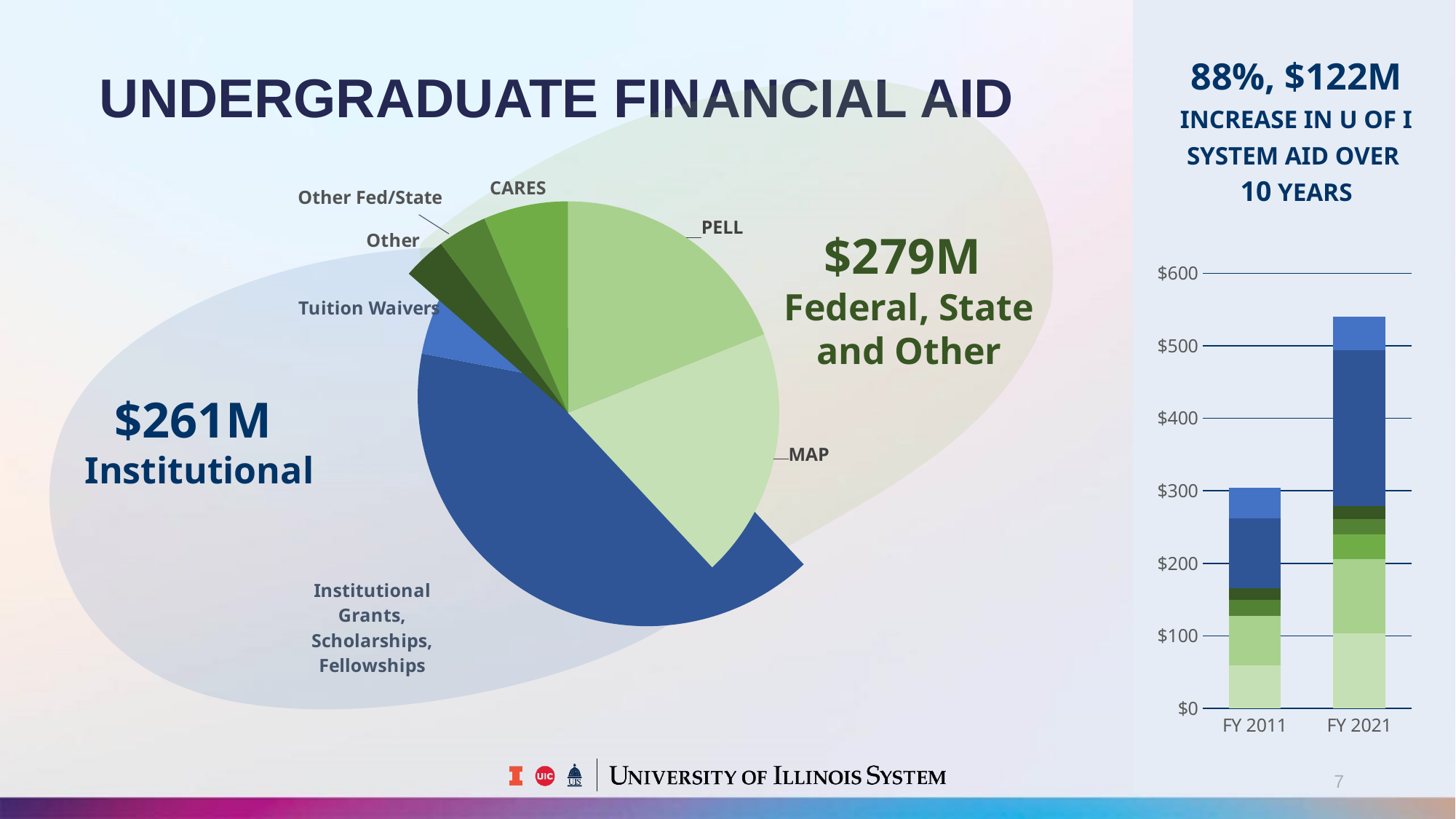
In the bar chart on the right, is the total for FY 2021 greater or less than $500? greater How many bars are in the bar chart on the right? 2 How many slices does the pie chart have? 7 In the bar chart on the right, does total aid rise or fall from FY 2011 to FY 2021? Rise What kind of chart is the large chart in the centre of the slide? Pie chart Which slice of the pie chart is the largest? Institutional Grants, Scholarships, Fellowships What is the difference between the Federal, State and Other total ($279M) and the Institutional total ($261M)? $18M In the pie chart, which slice is larger, Institutional Grants, Scholarships, Fellowships or PELL? Institutional Grants, Scholarships, Fellowships In the bar chart on the right, is the total for FY 2011 greater or less than $400? less What kind of chart is shown on the right side of the slide with FY 2011 and FY 2021? Bar chart According to the slide, which total is larger, Institutional aid or Federal, State and Other aid? Federal, State and Other